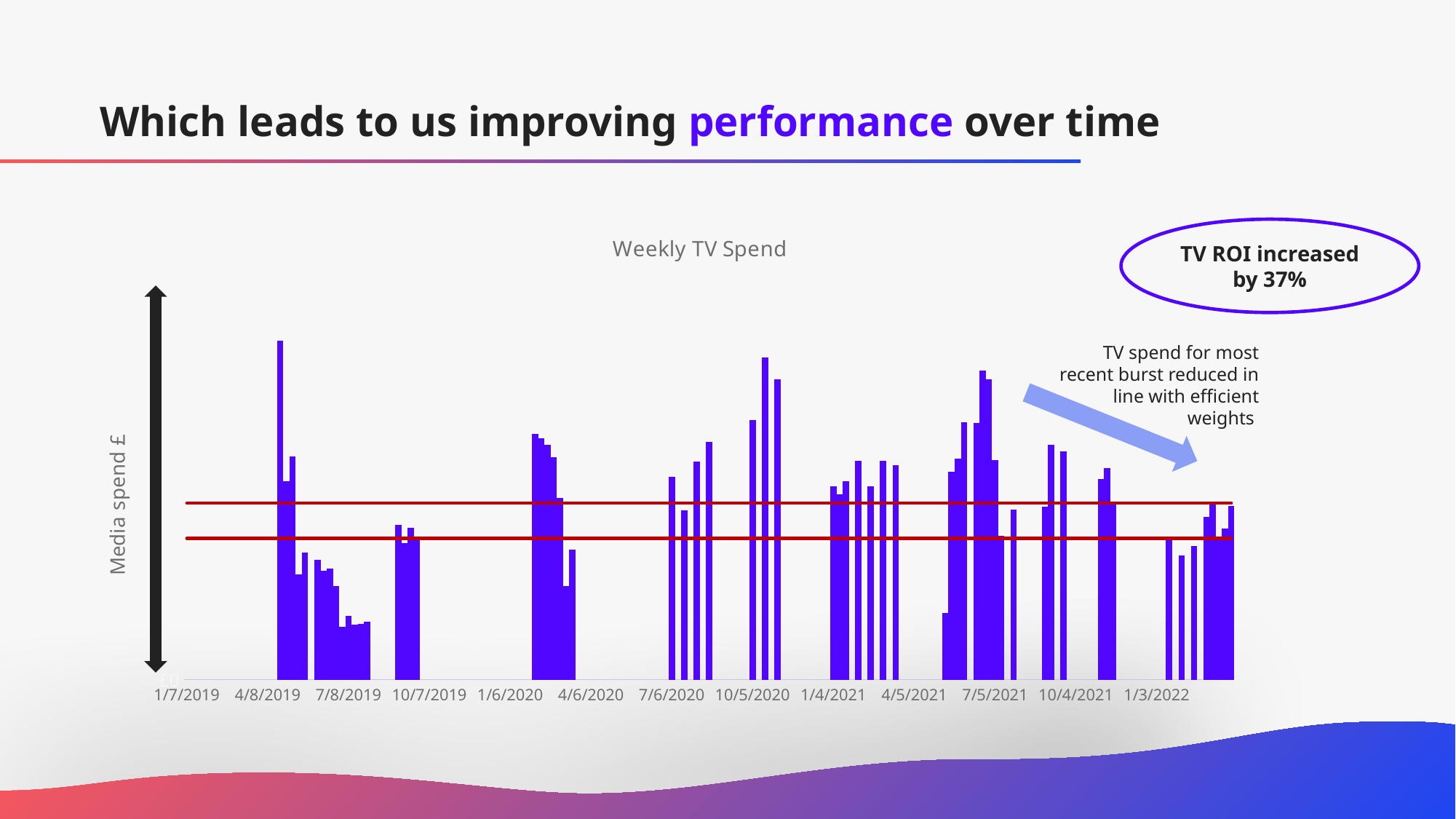
Which is taller: the tallest bar in the burst near 10/7/2019 or the tallest bar in the burst near 7/8/2019? 10/7/2019 Which is taller: the tallest bar in the burst near 10/4/2021 or the tallest bar in the final burst after 1/3/2022? 10/4/2021 What is the title of the chart? Weekly TV Spend What type of chart is shown on the slide? Bar chart How many date labels are shown along the x axis of the chart? 13 Is the tallest bar in the final burst after 1/3/2022 higher or lower than the tallest bar in the burst near 7/5/2021? Lower Which x-axis date label is the tallest bar in the chart located at? 4/8/2019 What is the label on the vertical axis of the chart? Media spend £ Which burst of spending has the lowest peak bar in the chart? 7/8/2019